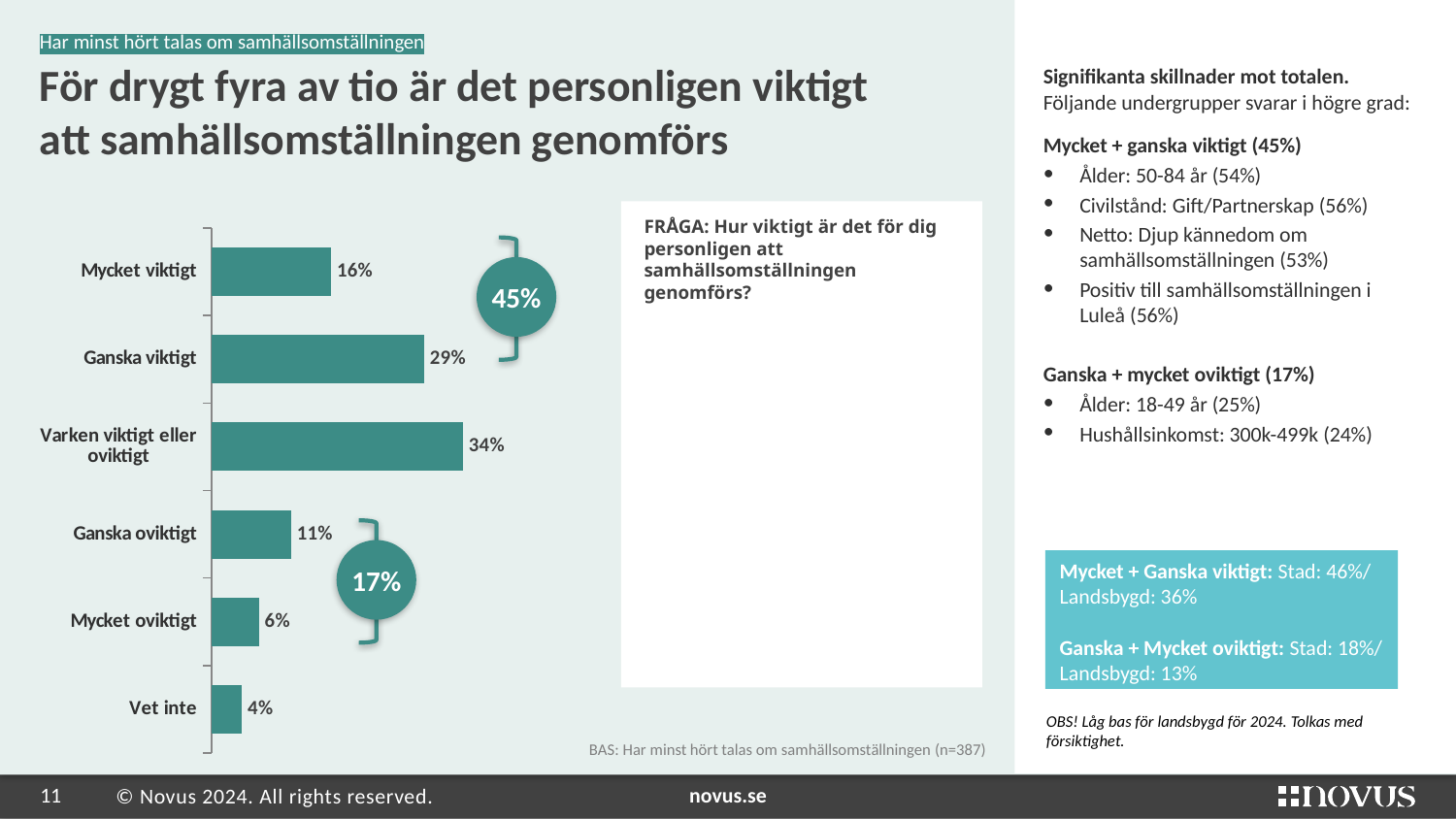
What is the value for "Mycket viktigt"? 16% Which category has the highest value? Varken viktigt eller oviktigt What is the value for "Varken viktigt eller oviktigt"? 34% What is the combined value shown for "Ganska oviktigt" and "Mycket oviktigt" in the bracket label? 17% How many categories are shown in the chart? 6 What kind of chart is shown on the slide? Bar chart What is the combined value shown for "Mycket viktigt" and "Ganska viktigt" in the bracket label? 45% What is the difference between "Ganska viktigt" and "Mycket viktigt"? 13% What is the value for "Vet inte"? 4% Which category has the lowest value? Vet inte Which is larger, "Ganska oviktigt" or "Mycket oviktigt"? Ganska oviktigt What is the value for "Ganska viktigt"? 29%